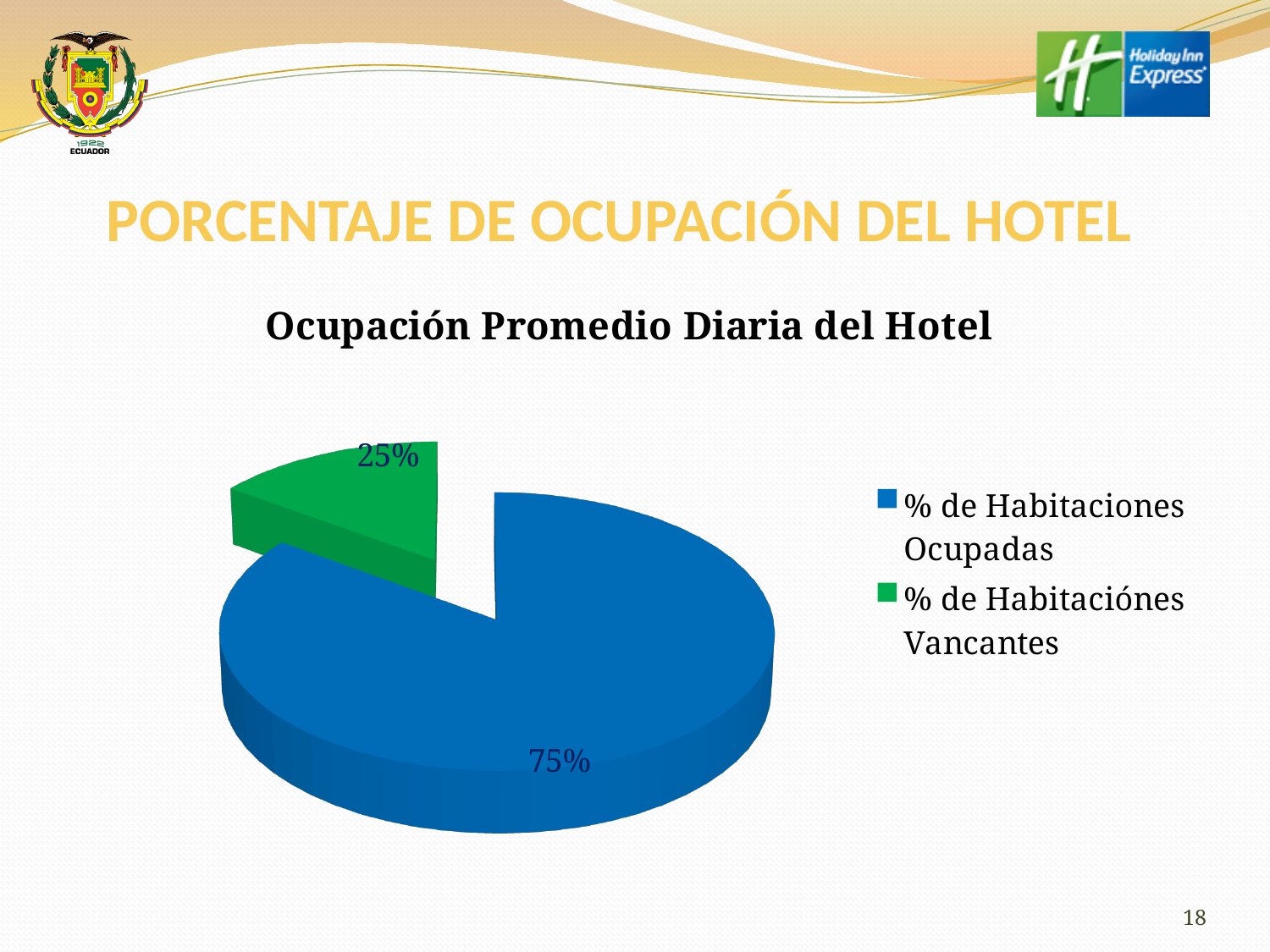
What share of the pie does the blue slice represent? 75% What type of chart is shown on the slide? Pie chart How many slices does the pie chart have? 2 Which is larger: the share of % de Habitaciones Ocupadas or % de Habitaciónes Vancantes? % de Habitaciones Ocupadas How many entries does the legend list? 2 What percentage is shown for % de Habitaciones Ocupadas? 75% What is the difference between the share of occupied rooms and vacant rooms? 50% What percentage is shown for % de Habitaciónes Vancantes? 25% Which category has the largest share of the pie? % de Habitaciones Ocupadas Which category has the smallest share of the pie? % de Habitaciónes Vancantes What colour is the slice for % de Habitaciónes Vancantes? Green What is the title of the chart? Ocupación Promedio Diaria del Hotel